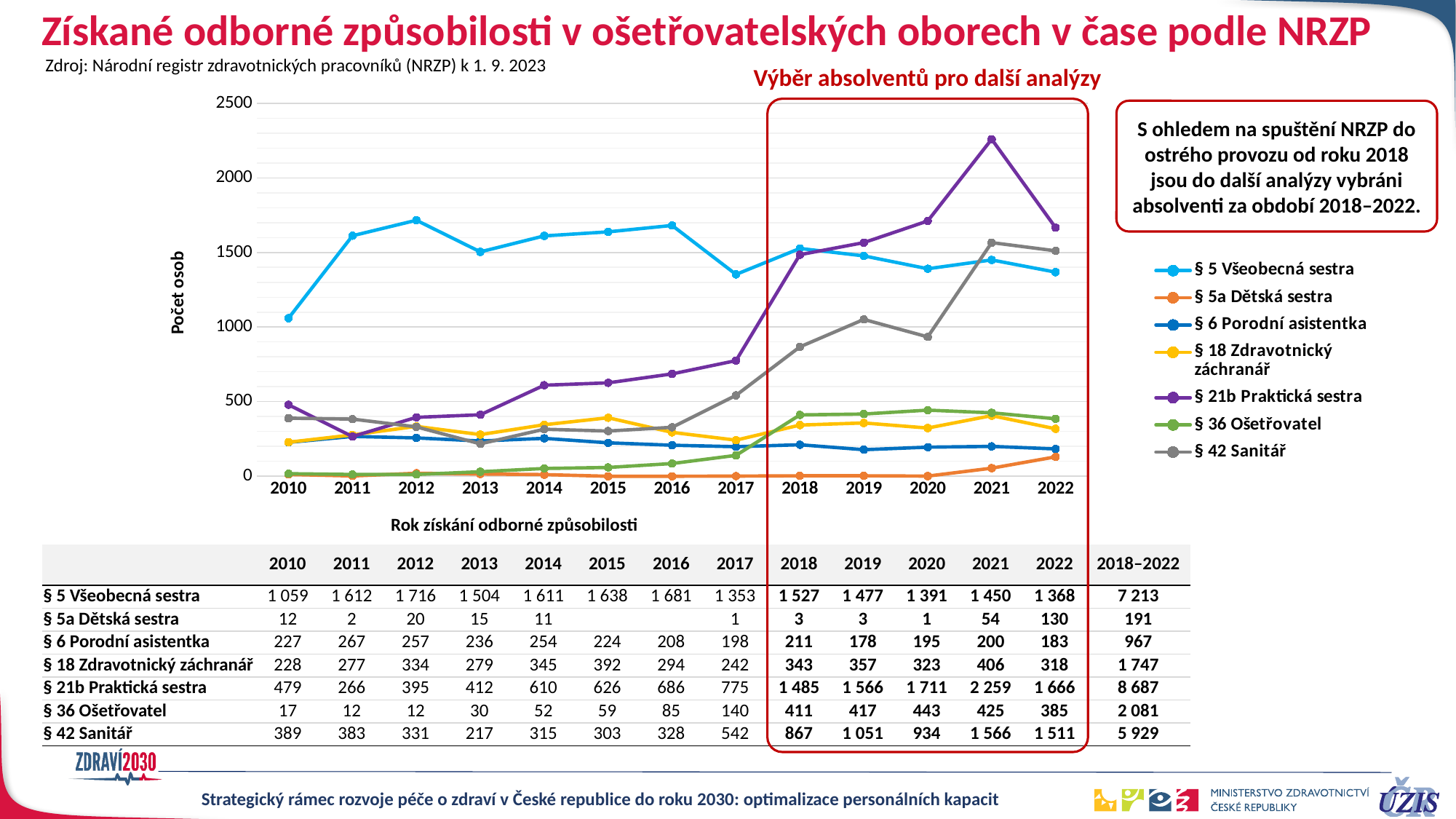
What is the 2018–2022 total for § 6 Porodní asistentka? 967 In 2018, which is larger: § 5 Všeobecná sestra or § 21b Praktická sestra? § 5 Všeobecná sestra What is the value for § 5 Všeobecná sestra in 2012? 1 716 Does the value for § 36 Ošetřovatel rise or fall from 2010 to 2018? rise By how much did the value for § 42 Sanitář increase from 2020 to 2021? 632 What type of chart is shown on the slide? line chart How many years are plotted along the x axis of the chart? 13 Which series has the lowest value in 2022? § 5a Dětská sestra How many series does the legend of the chart list? 7 What is the value for § 21b Praktická sestra in 2021? 2 259 Is the value for § 42 Sanitář in 2019 greater or less than 1000? greater Which series reaches the highest value on the chart, and in which year? § 21b Praktická sestra in 2021